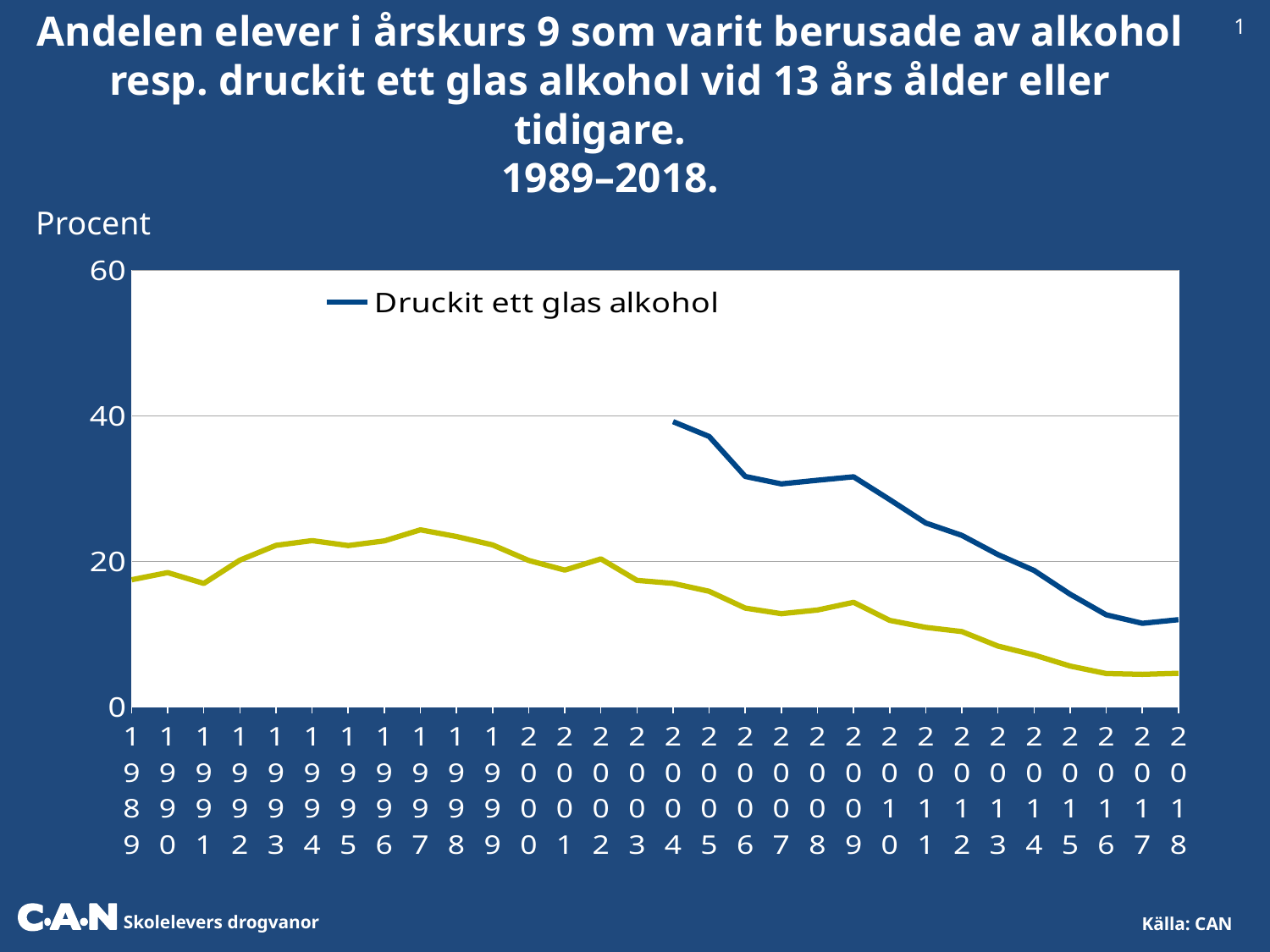
What is the label shown above the y axis? Procent Is the value for Druckit ett glas alkohol in 2018 greater or less than 20? less Does the Druckit ett glas alkohol line rise or fall from 2004 to 2018? Fall What kind of chart is shown on the slide? Line chart Is the value of the yellow line in 1997 greater or less than 20? greater Is the value for Druckit ett glas alkohol in 2005 greater or less than 40? less How many years are shown along the x axis? 30 How many series does the chart's legend list? 1 In 2018, which line has the higher value, Druckit ett glas alkohol or the yellow line? Druckit ett glas alkohol What is the name of the series listed in the legend? Druckit ett glas alkohol